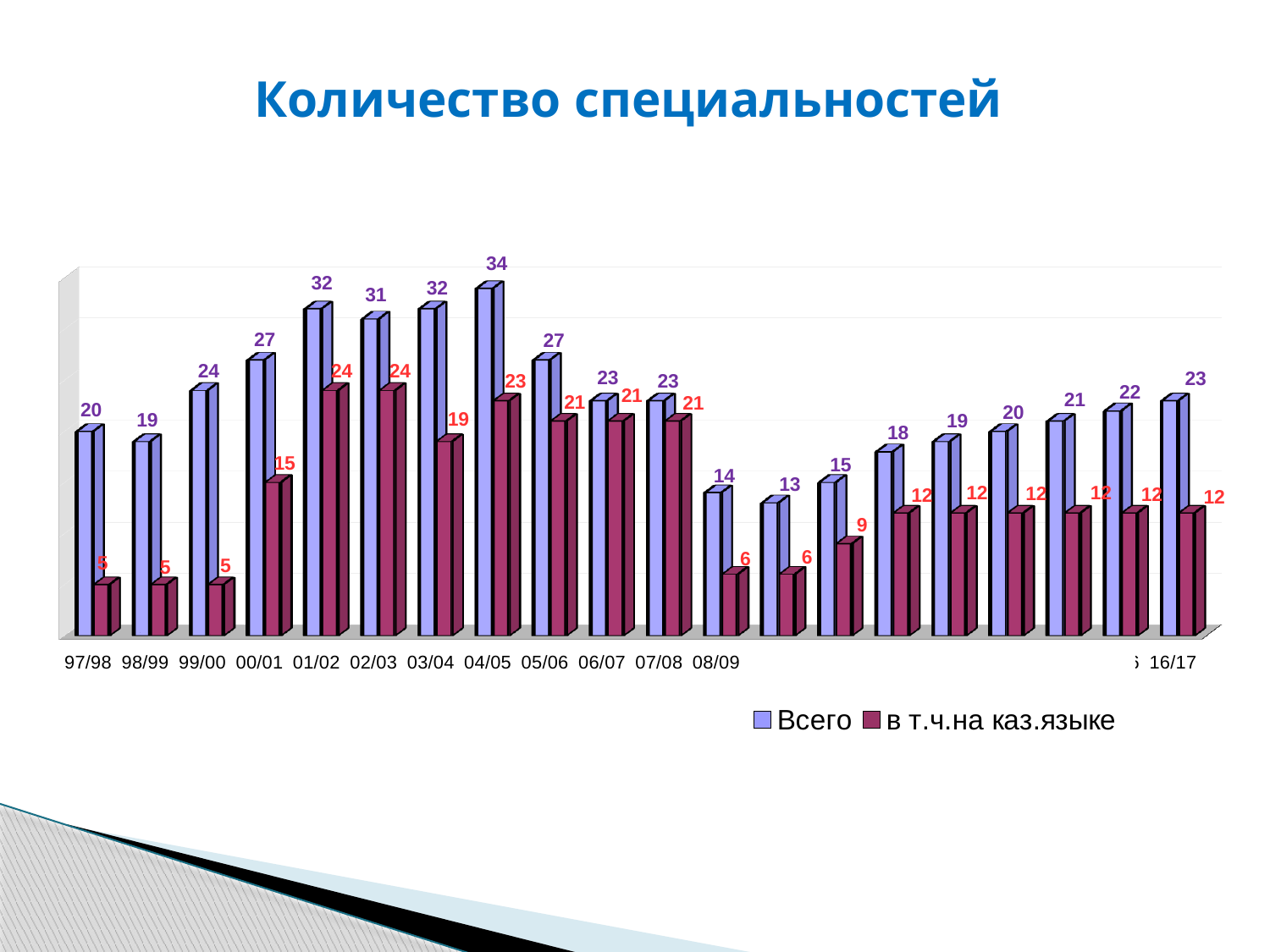
How many series does the legend list? 2 What is the value of the 'Всего' series for 04/05? 34 What is the value of the 'в т.ч.на каз.языке' series for 03/04? 19 What is the value of the 'в т.ч.на каз.языке' series for 16/17? 12 Does the 'Всего' series rise or fall from 04/05 to 08/09? Fall Which year has the larger 'Всего' value, 01/02 or 02/03? 01/02 What is the value of the 'в т.ч.на каз.языке' series for 00/01? 15 What is the difference between 'Всего' and 'в т.ч.на каз.языке' for 04/05? 11 What is the difference between 'Всего' and 'в т.ч.на каз.языке' for 08/09? 8 How many categories (years) are plotted in the chart? 20 What kind of chart is shown on the slide? Bar chart In which year is the 'Всего' value the highest? 04/05